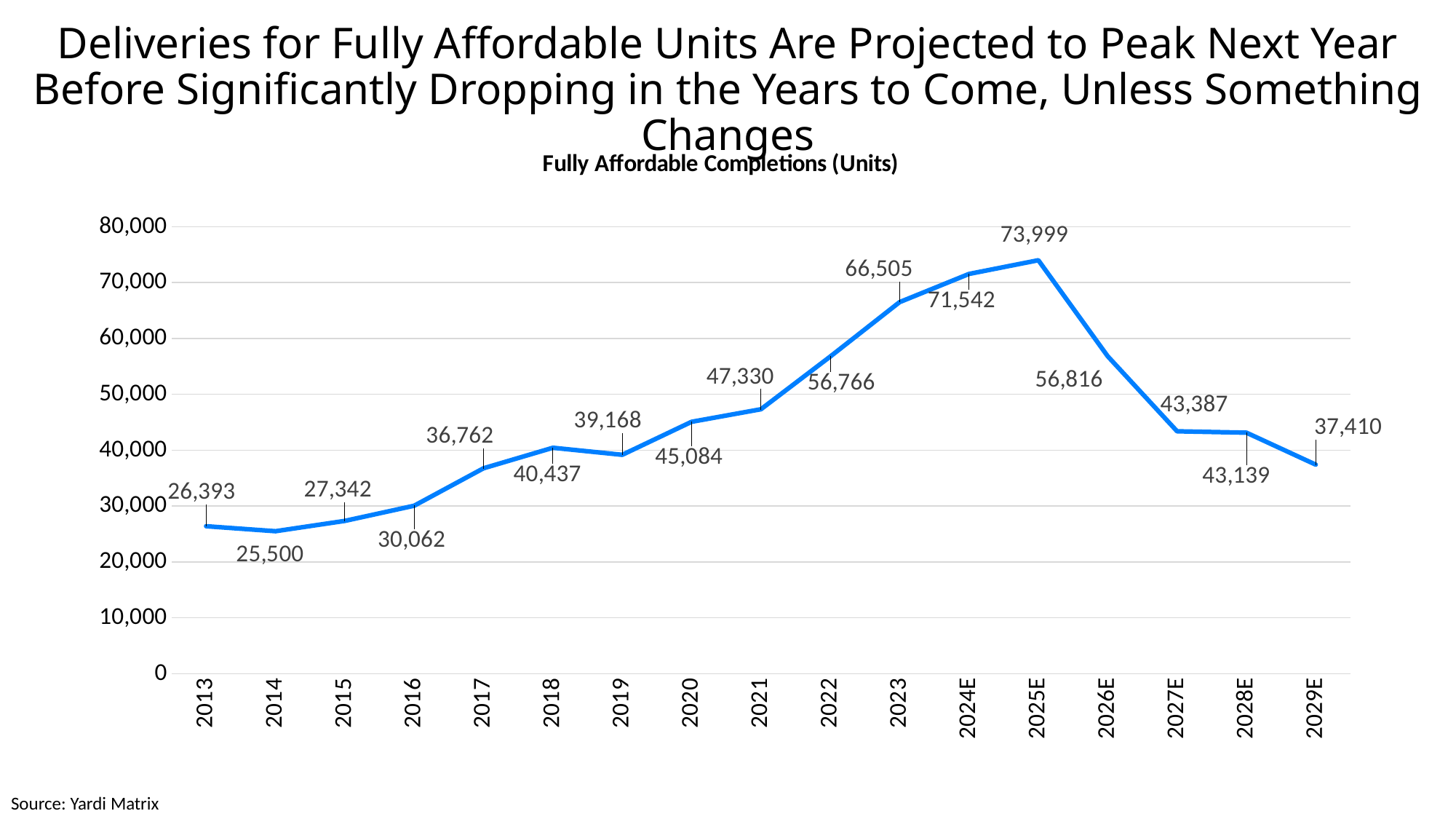
What is the difference between the values for 2025E and 2026E? 17,183 Do the values rise or fall from 2025E to 2029E? fall Which year has the lowest value? 2014 What is the value for 2016? 30,062 Which is larger, the value for 2018 or the value for 2019? 2018 What is the value for 2029E? 37,410 Is the value for 2022 greater or less than 50,000? greater What is the difference between the values for 2023 and 2022? 9,739 What kind of chart is shown? line chart Which year has the highest value? 2025E What is the value for 2025E? 73,999 How many years are plotted on the x axis? 17